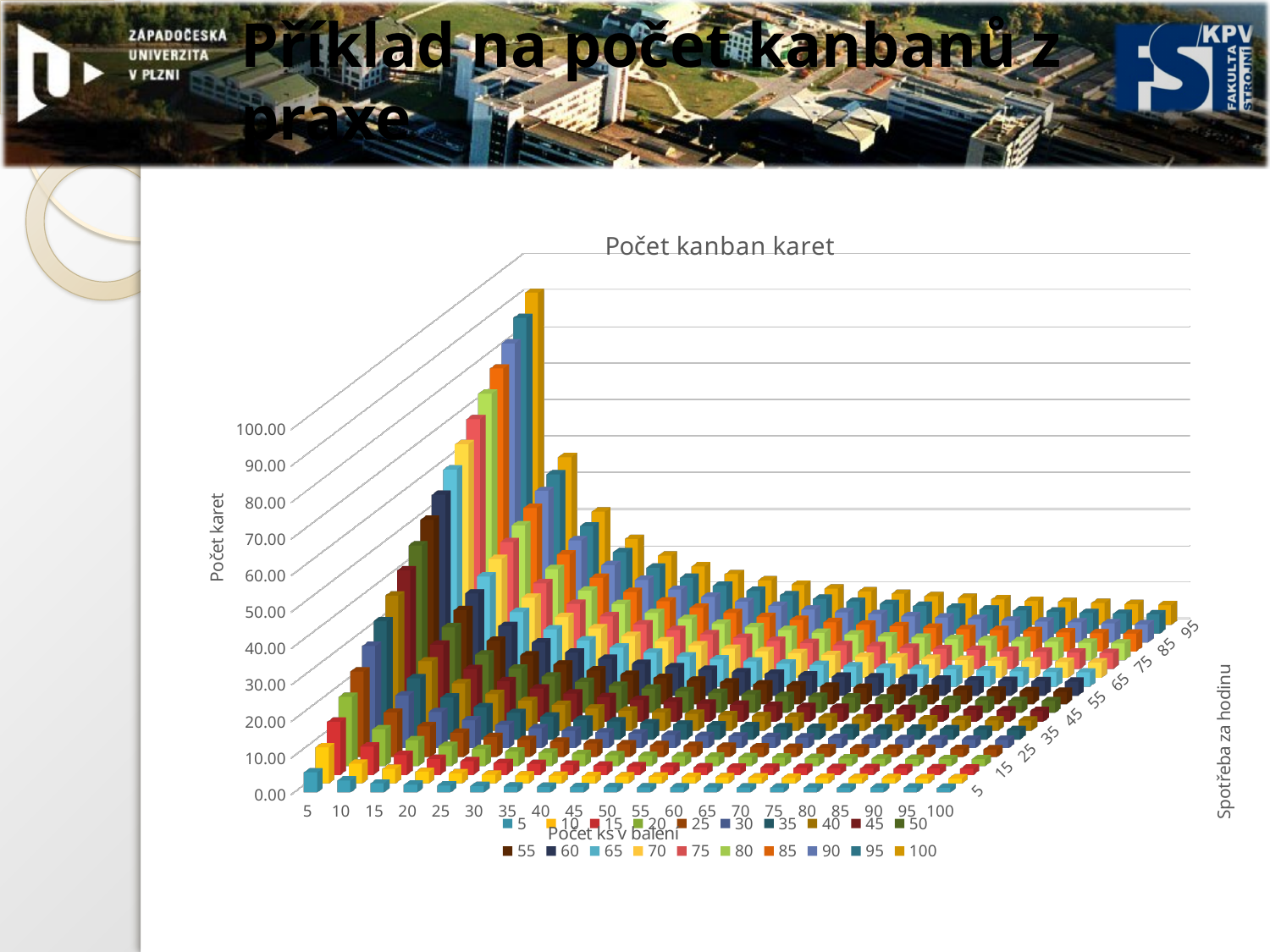
Which 'Počet ks v balení' category has the tallest bars? 5 Which 'Počet ks v balení' category has the lowest bars? 100 Do the bar heights rise or fall as 'Počet ks v balení' increases along the x axis? fall How many series does the legend list? 20 Is the bar for series 100 at 'Počet ks v balení' = 5 greater or less than 50.00? greater What is the title of the chart? Počet kanban karet Is the bar for series 5 at 'Počet ks v balení' = 5 greater or less than 20.00? less What is the label of the vertical axis? Počet karet How many categories are shown on the 'Počet ks v balení' axis? 20 Which is larger: the bar for series 100 at 'Počet ks v balení' = 5 or the bar for series 100 at 'Počet ks v balení' = 100? series 100 at 5 Which series has the tallest bar at 'Počet ks v balení' = 5? 100 What kind of chart is shown on the slide? bar chart